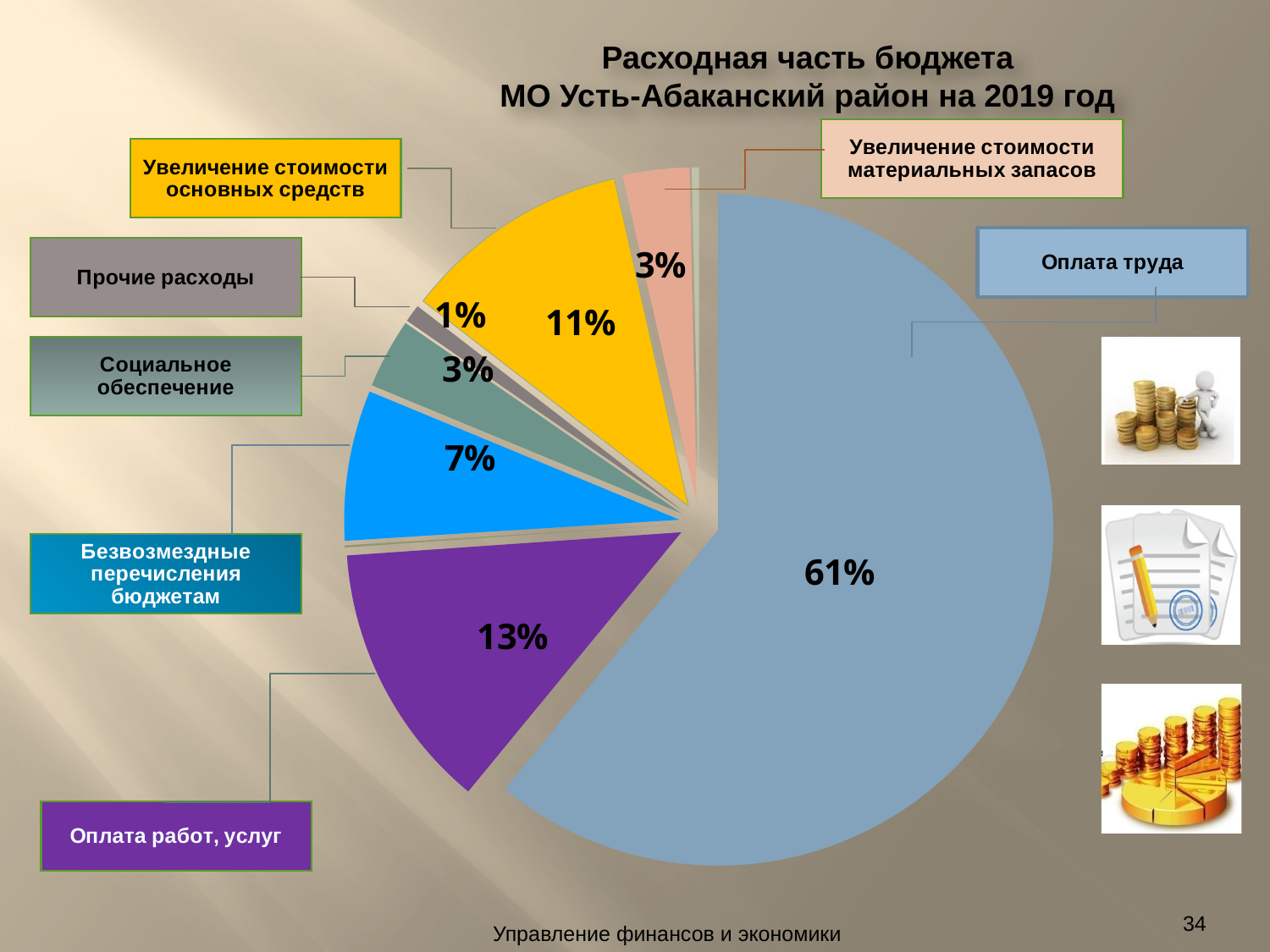
What share of the budget expenditure is Прочие расходы? 1% What kind of chart is shown on the slide? pie chart What is the title of the chart? Расходная часть бюджета МО Усть-Абаканский район на 2019 год What share of the budget expenditure is Оплата работ, услуг? 13% How many slices does the pie chart have? 9 What share of the budget expenditure is Увеличение стоимости основных средств? 11% Which category has the largest share of the pie? Оплата труда What is the difference in percentage points between Оплата труда and Оплата работ, услуг? 48 Which is larger: Увеличение стоимости основных средств or Безвозмездные перечисления бюджетам? Увеличение стоимости основных средств